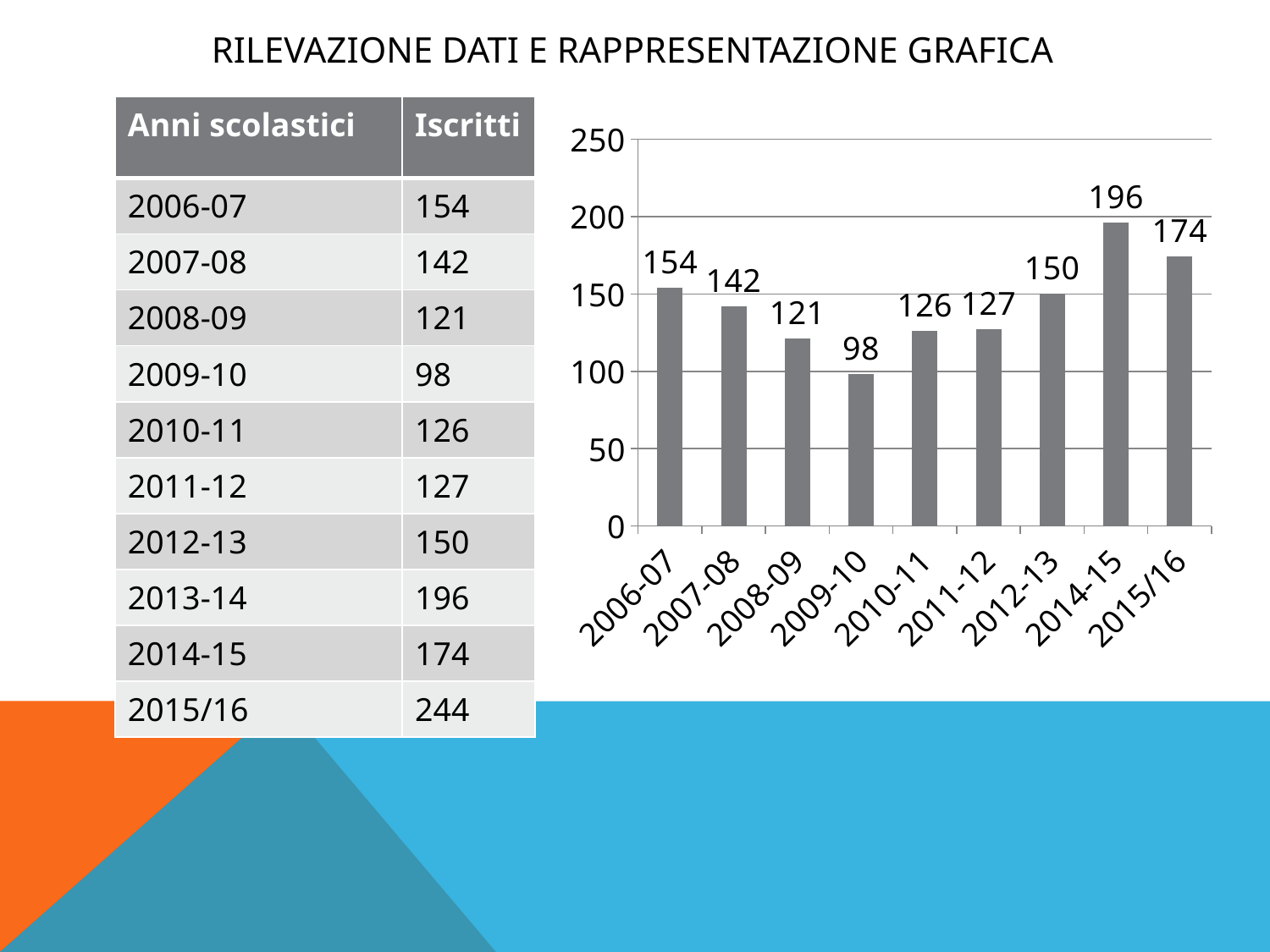
How many bars are shown in the chart? 9 What is the value for 2015/16 in the chart? 174 What is the value for 2012-13 in the chart? 150 Which category has the highest value in the chart? 2014-15 What is the value for 2009-10 in the chart? 98 What is the difference between the values for 2006-07 and 2009-10 in the chart? 56 Which category has the lowest value in the chart? 2009-10 Is the value for 2012-13 greater or less than 100? greater What is the value for 2006-07 in the chart? 154 Which is larger in the chart, the value for 2007-08 or the value for 2008-09? 2007-08 What is the difference between the values for 2014-15 and 2015/16 in the chart? 22 What kind of chart is shown on the slide? bar chart